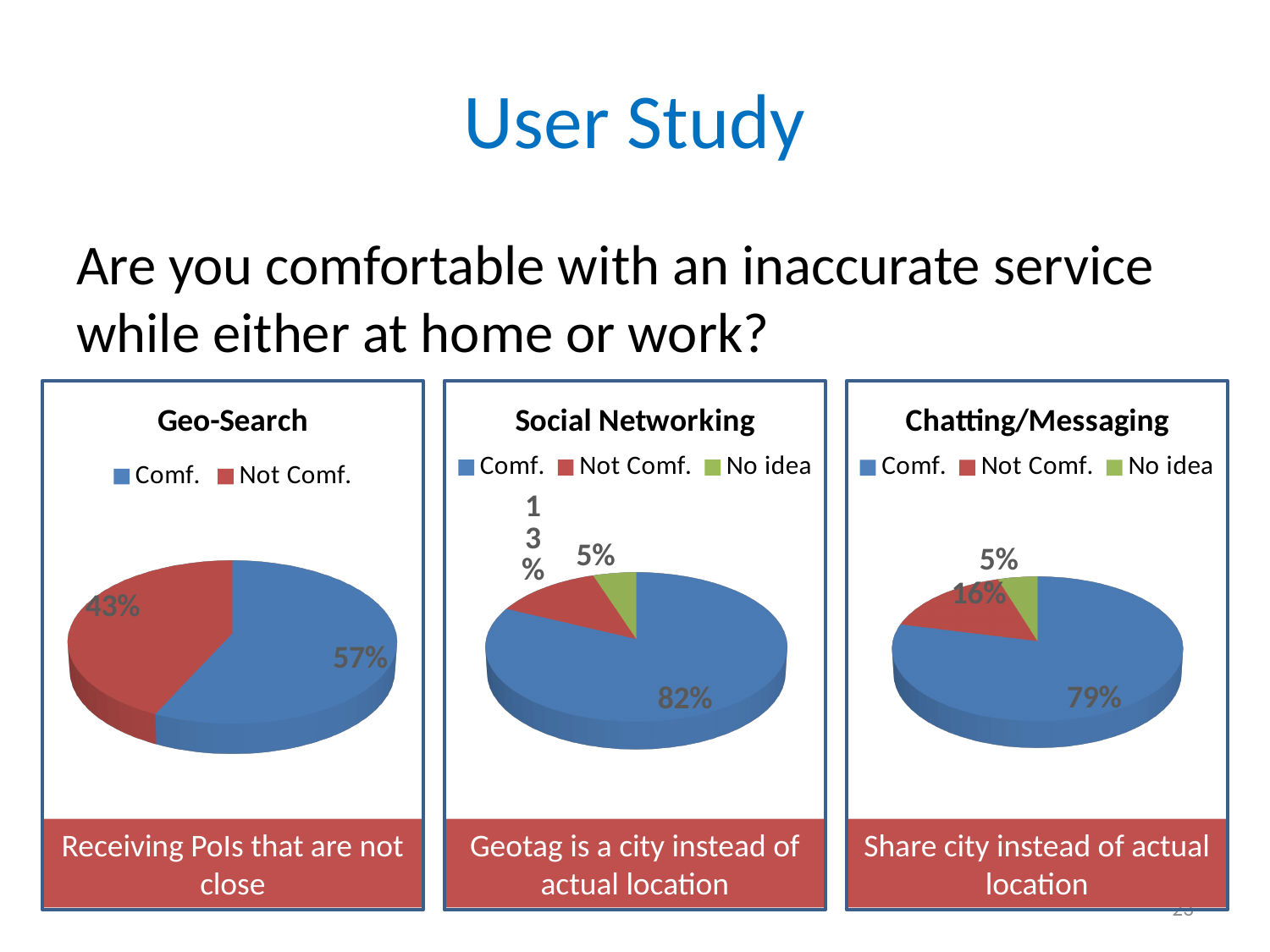
In the Geo-Search chart, what percentage of respondents are Comf.? 57% In the Social Networking chart, what share of the pie is Comf.? 82% In the Geo-Search chart, what percentage of respondents are Not Comf.? 43% In the Geo-Search chart, what is the difference between the Comf. and Not Comf. percentages? 14% In the Social Networking chart, what percentage answered No idea? 5% In the Chatting/Messaging chart, what percentage of respondents are Comf.? 79% What type of chart is the Geo-Search chart? Pie chart In the Chatting/Messaging chart, what percentage answered No idea? 5% How many series does the legend of the Chatting/Messaging chart list? 3 Which is larger: the Comf. share in the Social Networking chart or the Comf. share in the Chatting/Messaging chart? Social Networking In the Geo-Search chart, which category has the largest slice? Comf. In the Social Networking chart, which category has the smallest slice? No idea